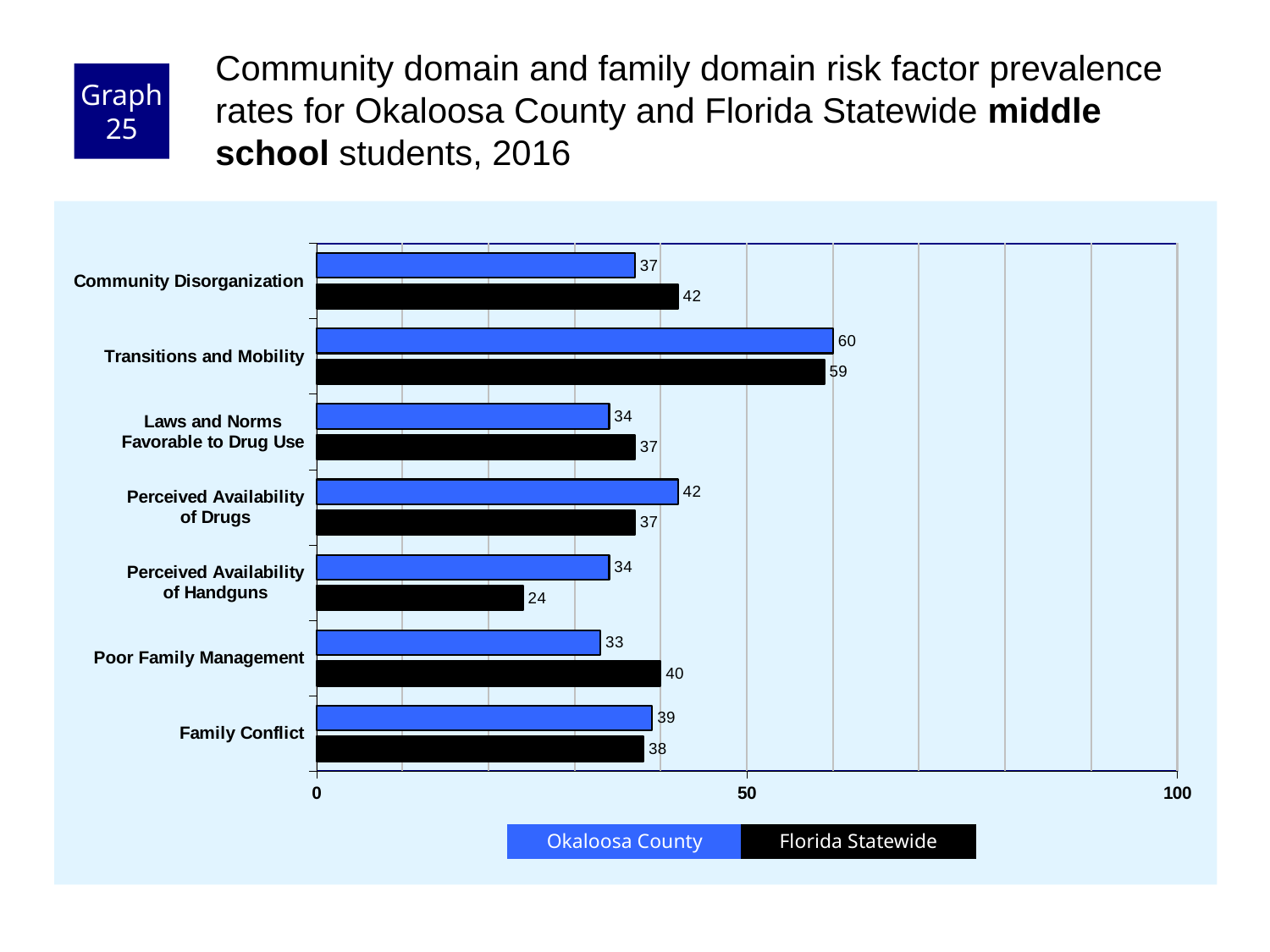
Is the Okaloosa County value for Transitions and Mobility greater or less than 50? greater Which risk factor has the highest Okaloosa County value? Transitions and Mobility Which risk factor has the lowest Florida Statewide value? Perceived Availability of Handguns How many risk factors are shown on the chart? 7 What is the Okaloosa County value for Transitions and Mobility? 60 What is the Florida Statewide value for Poor Family Management? 40 What kind of chart is shown on the slide? bar chart How many series does the legend list? 2 Which colour represents Florida Statewide in the chart? black What is the Florida Statewide value for Perceived Availability of Handguns? 24 For Community Disorganization, which is larger: the Okaloosa County value or the Florida Statewide value? Florida Statewide What is the difference between the Okaloosa County and Florida Statewide values for Perceived Availability of Handguns? 10